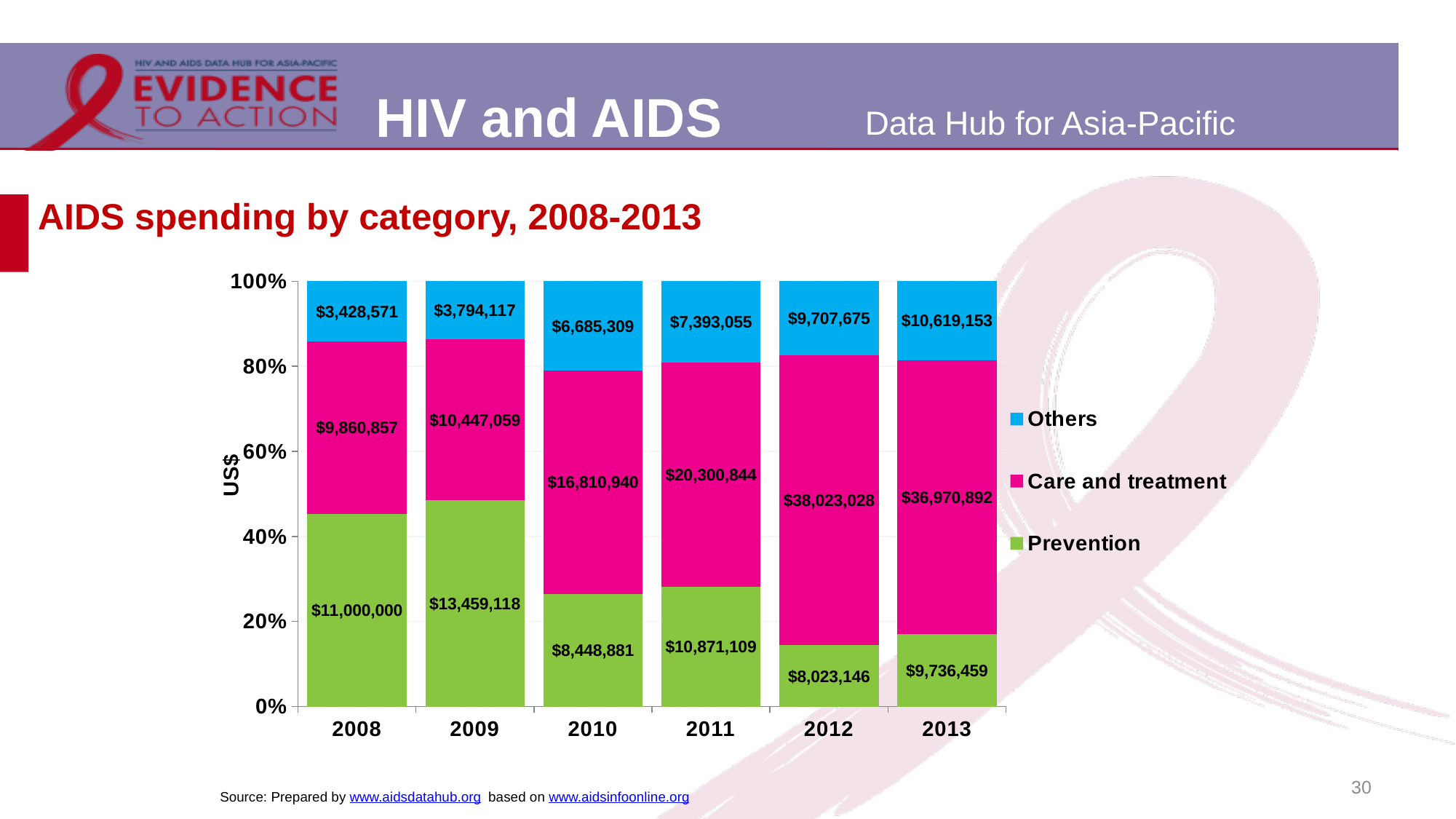
Which is larger: Prevention spending in 2009 or Prevention spending in 2011? Prevention spending in 2009 Is the Prevention share of the 2008 bar greater or less than 40%? greater What was the Care and treatment spending in 2012? $38,023,028 How many series does the legend list? 3 In which year was Others spending highest? 2013 What is the difference between Care and treatment spending in 2012 and 2013? $1,052,136 What was the Others spending in 2010? $6,685,309 In which year was Prevention spending lowest? 2012 What is the total AIDS spending across all three categories in 2008? $24,289,428 How many years are shown on the x axis? 6 What was the Prevention spending in 2008? $11,000,000 What type of chart is shown on the slide? Stacked bar chart